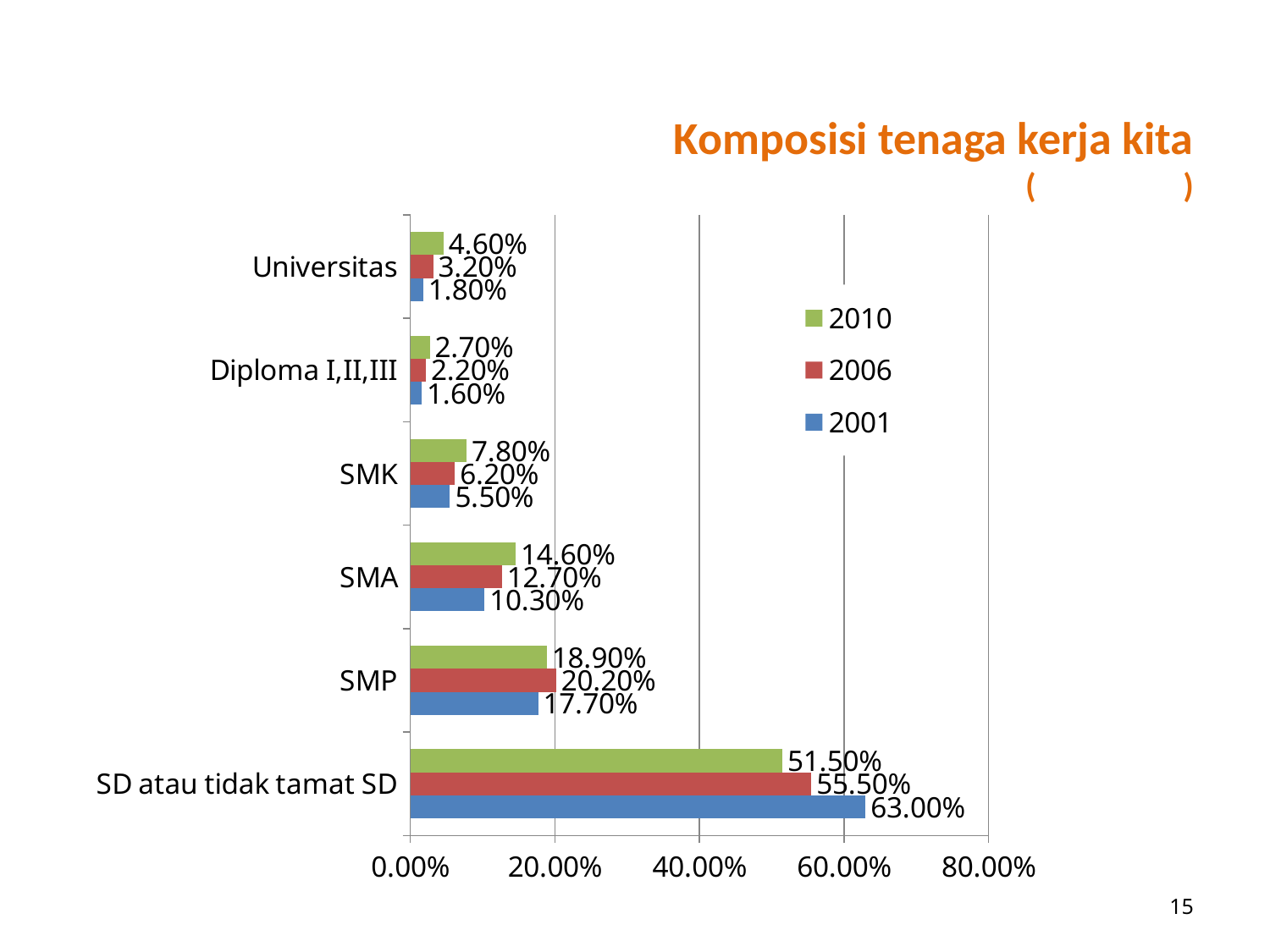
Is the value for SD atau tidak tamat SD in 2006 greater or less than 40.00%? greater What is the value for SMA in 2010? 14.60% What is the difference between the 2001 and 2010 values for SD atau tidak tamat SD? 11.50% Which is larger for SMP: the 2006 value or the 2010 value? 2006 What kind of chart is shown? Bar chart What is the value for SD atau tidak tamat SD in 2001? 63.00% What is the value for Diploma I,II,III in 2006? 2.20% How many categories are shown on the y axis? 6 Which category has the lowest value in 2001? Diploma I,II,III Which category has the highest value in 2010? SD atau tidak tamat SD How many series does the legend list? 3 Which series is shown in green in the legend? 2010